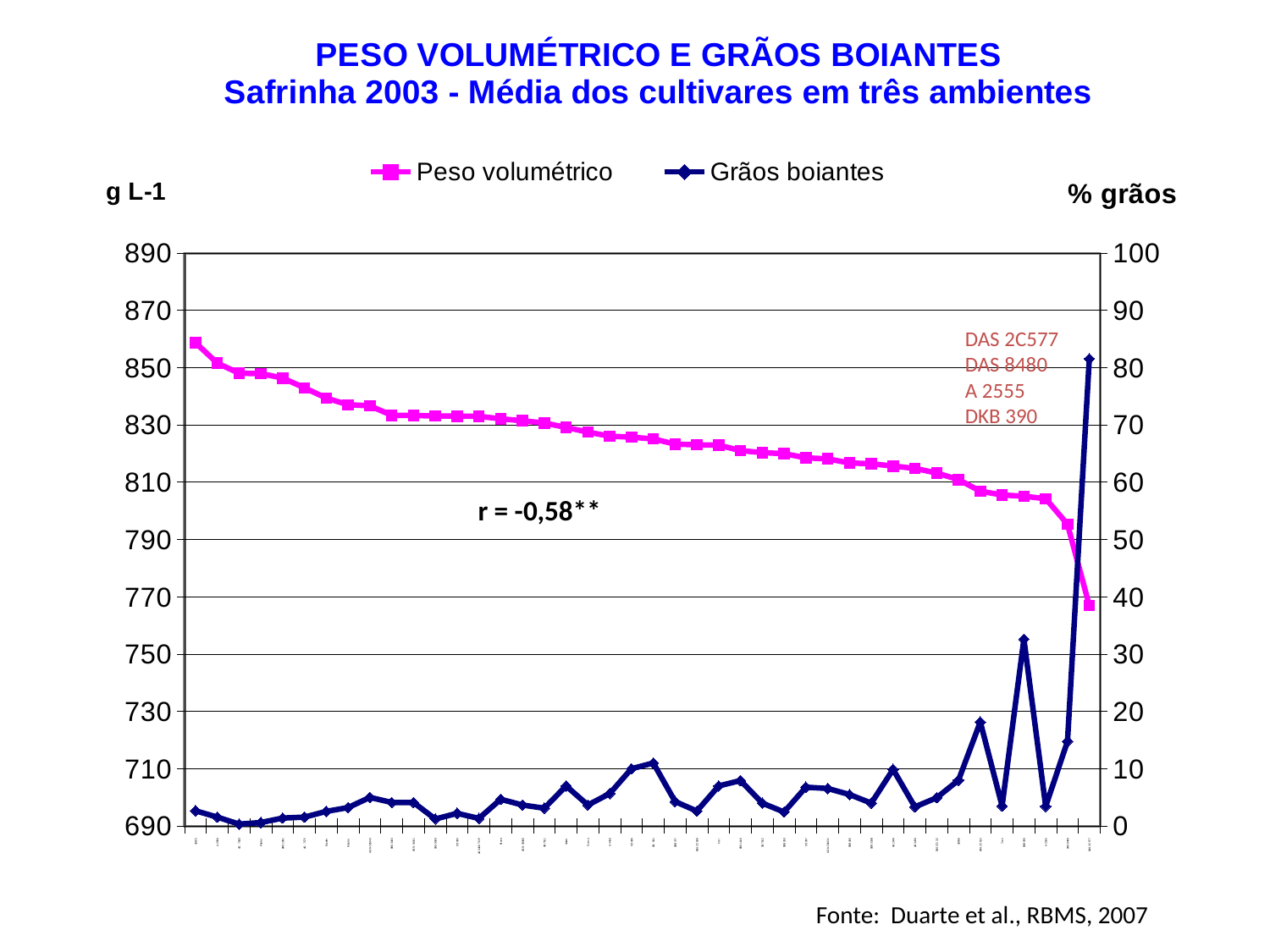
Which is larger for Peso volumétrico: the leftmost point or the rightmost point? the leftmost point Is the last (rightmost) value of Grãos boiantes greater or less than 70? greater Does the Peso volumétrico series rise or fall from left to right along the x axis? fall What is the title of the chart? PESO VOLUMÉTRICO E GRÃOS BOIANTES Safrinha 2003 - Média dos cultivares em três ambientes Is the first (leftmost) value of Peso volumétrico greater or less than 850? greater How many series does the legend list? 2 Where along the x axis does the Grãos boiantes series reach its highest value? at the last (rightmost) point What kind of chart is shown on the slide? line chart Is the first (leftmost) value of Grãos boiantes greater or less than 10? less What correlation coefficient is printed on the chart? r = -0,58** What are the two series named in the legend? Peso volumétrico and Grãos boiantes